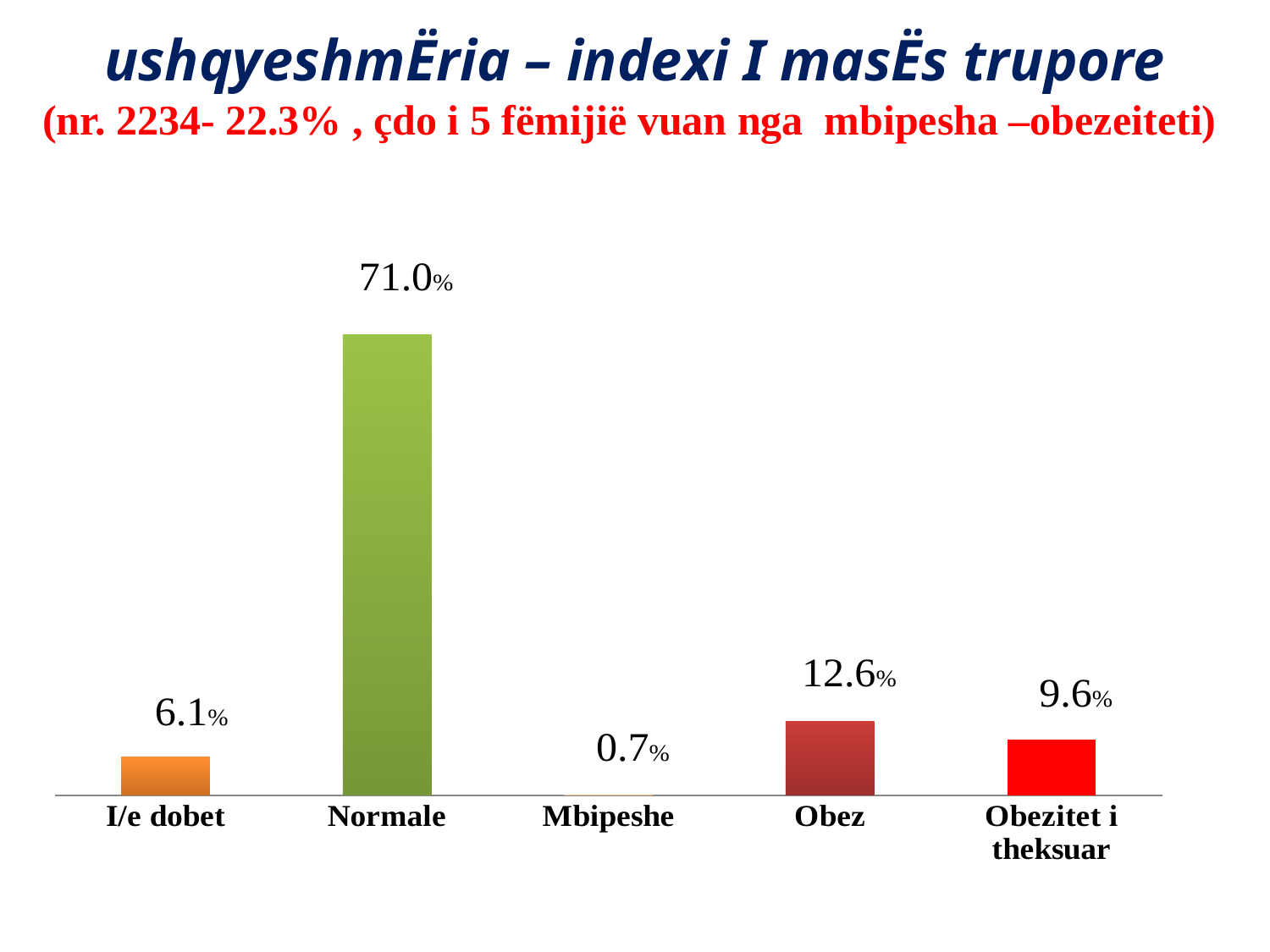
What is the value for I/e dobet? 6.1% What is the value for Normale? 71.0% How many categories are shown on the x axis? 5 What is the value for Obez? 12.6% Which category has the lowest value? Mbipeshe What kind of chart is shown on the slide? Bar chart Which is larger, the value for I/e dobet or the value for Obezitet i theksuar? Obezitet i theksuar What colour is the bar for Normale? Green What is the difference between the values for Obez and Obezitet i theksuar? 3.0% What is the value for Obezitet i theksuar? 9.6% What is the value for Mbipeshe? 0.7% Which category has the highest value? Normale